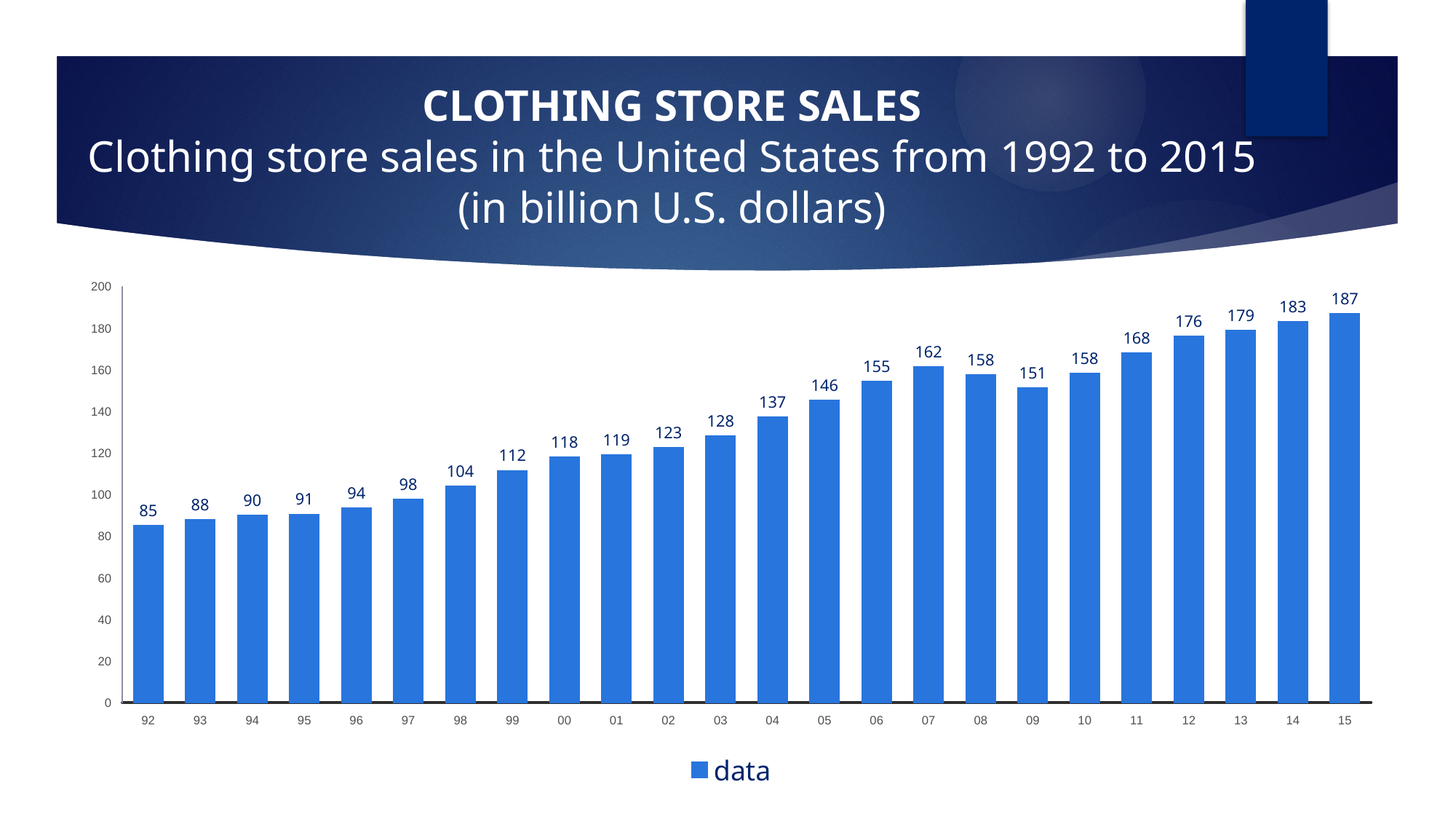
Is the value for 05 greater or less than 140? greater What is the difference between the values for 15 and 92? 102 How many bars are in the chart? 24 What is the value for 92? 85 What is the value for 09? 151 What kind of chart is shown? bar chart What is the difference between the values for 08 and 09? 7 What is the value for 15? 187 Which is larger, the value for 07 or the value for 09? 07 Which year has the highest value? 15 What is the name of the series in the legend? data Which year has the lowest value? 92